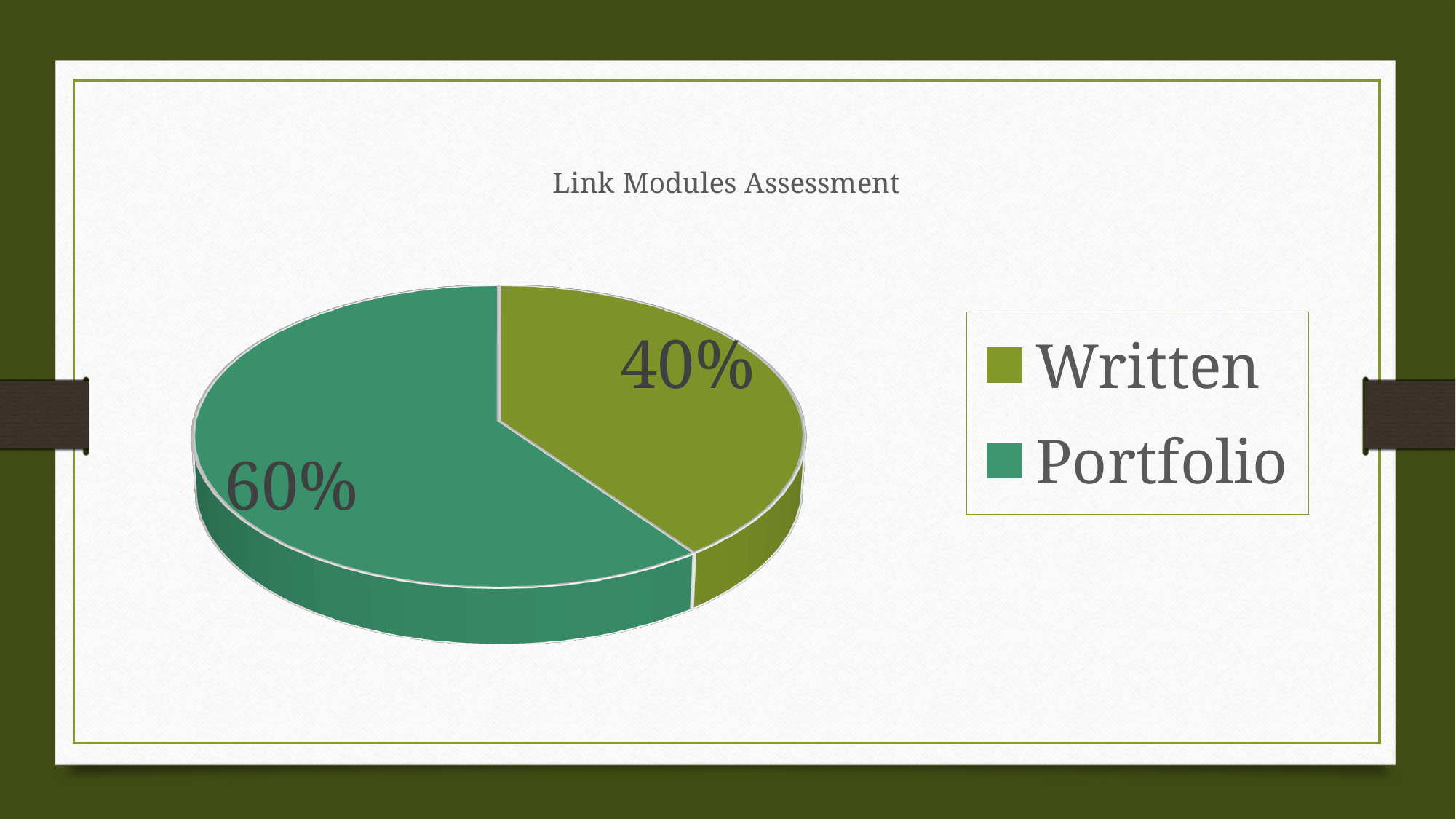
Which category has the largest share of the pie? Portfolio Which colour represents Portfolio in the chart? Teal green What percentage does the Written slice represent? 40% What is the difference between the Portfolio share and the Written share? 20% How many entries does the legend list? 2 How many slices does the pie chart have? 2 What is the title of the chart? Link Modules Assessment What type of chart is shown on the slide? Pie chart Which is larger, the Written share or the Portfolio share? Portfolio What percentage does the Portfolio slice represent? 60% Which category has the smallest share of the pie? Written